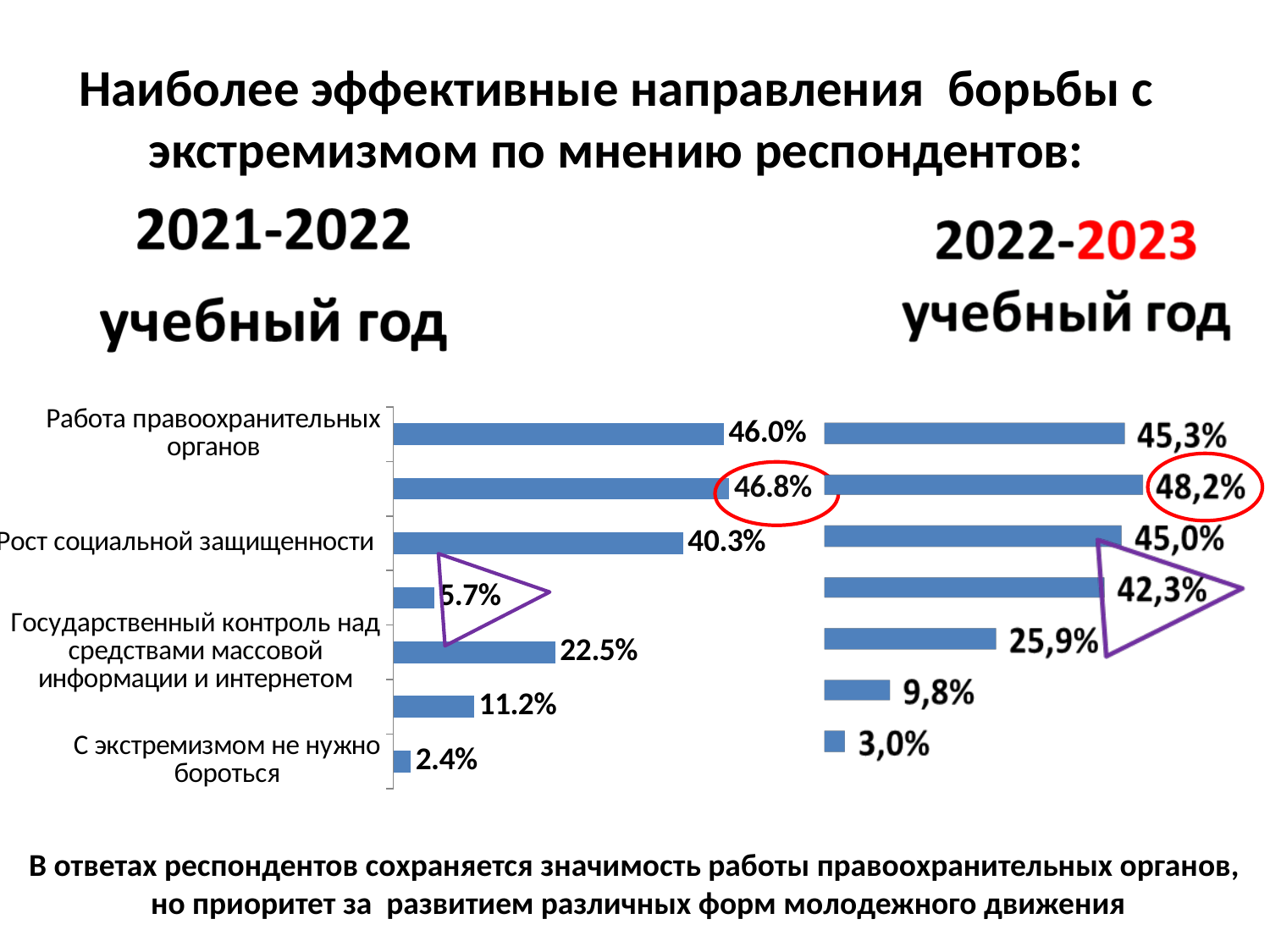
In the 2021-2022 учебный год chart, what is the value for Рост социальной защищенности? 40.3% What kind of chart is used on this slide? Bar chart In the 2021-2022 учебный год chart, which is larger: Работа правоохранительных органов or С экстремизмом не нужно бороться? Работа правоохранительных органов In the 2021-2022 учебный год chart, what is the value for Работа правоохранительных органов? 46.0% In the 2022-2023 учебный год chart, what is the value of the top bar? 45,3% In the 2021-2022 учебный год chart, what is the value for Государственный контроль над средствами массовой информации и интернетом? 22.5% In the 2022-2023 учебный год chart, what is the highest value shown? 48,2% In the 2021-2022 учебный год chart, what is the value for С экстремизмом не нужно бороться? 2.4% In the 2021-2022 учебный год chart, what is the difference between Работа правоохранительных органов and Рост социальной защищенности? 5.7% In the 2021-2022 учебный год chart, what is the highest value shown? 46.8% In the 2022-2023 учебный год chart, what is the lowest value shown? 3,0% How many bars are in the 2021-2022 учебный год chart? 7